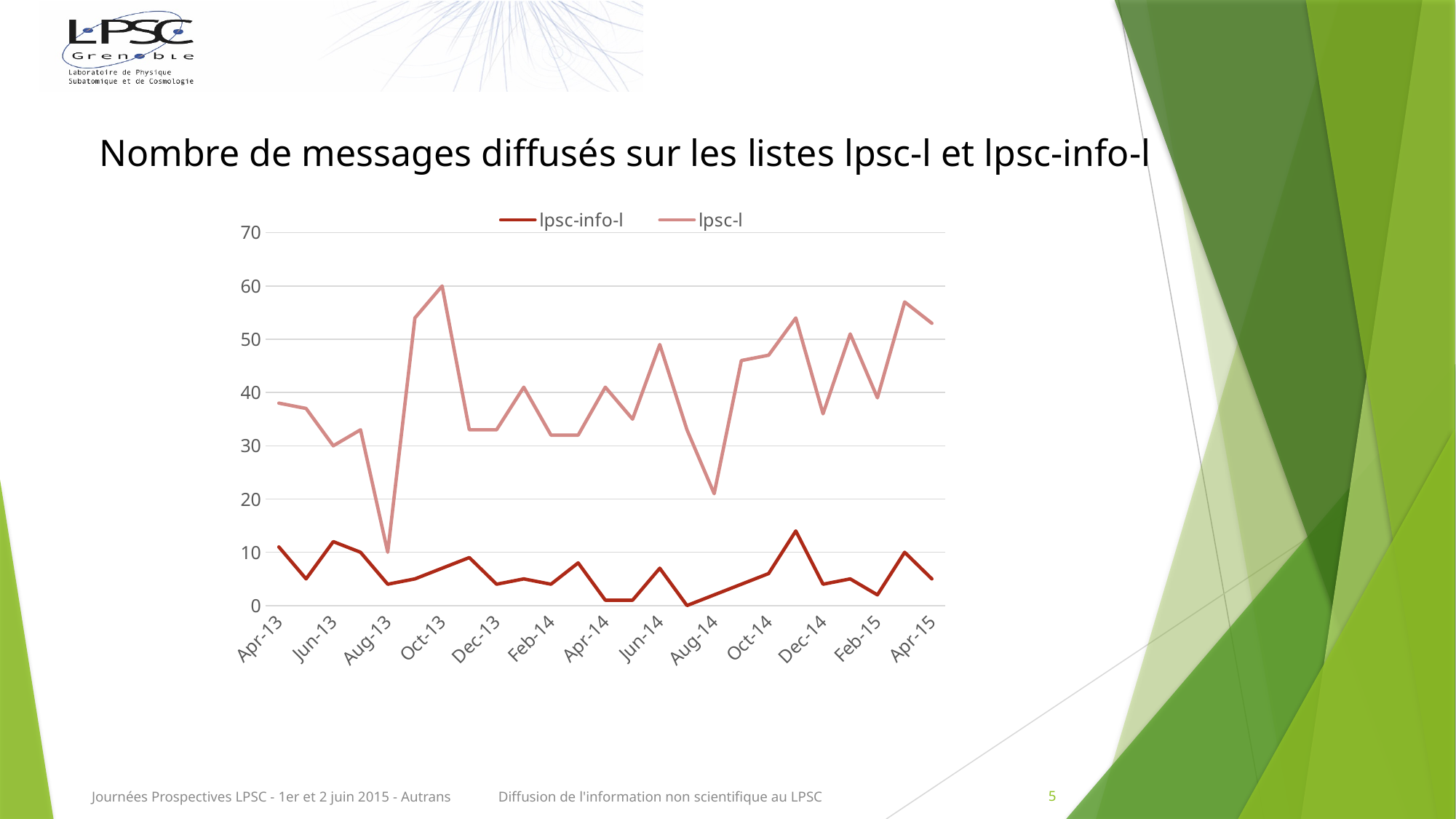
What is the title of the slide above the chart? Nombre de messages diffusés sur les listes lpsc-l et lpsc-info-l Is the value for lpsc-info-l at Dec-14 greater or less than 10? less Is the value for lpsc-l at Oct-13 greater or less than 50? greater At which labelled month does the lpsc-l series reach its highest value? Oct-13 How many series does the legend list? 2 Is the value for lpsc-l at Aug-13 greater or less than 20? less At which labelled month does the lpsc-l series reach its lowest value? Aug-13 At Apr-15, which series has the larger value, lpsc-l or lpsc-info-l? lpsc-l What kind of chart is shown on the slide? line chart What are the two series named in the legend? lpsc-info-l and lpsc-l Does the lpsc-l series rise or fall between Aug-13 and Oct-13? rise